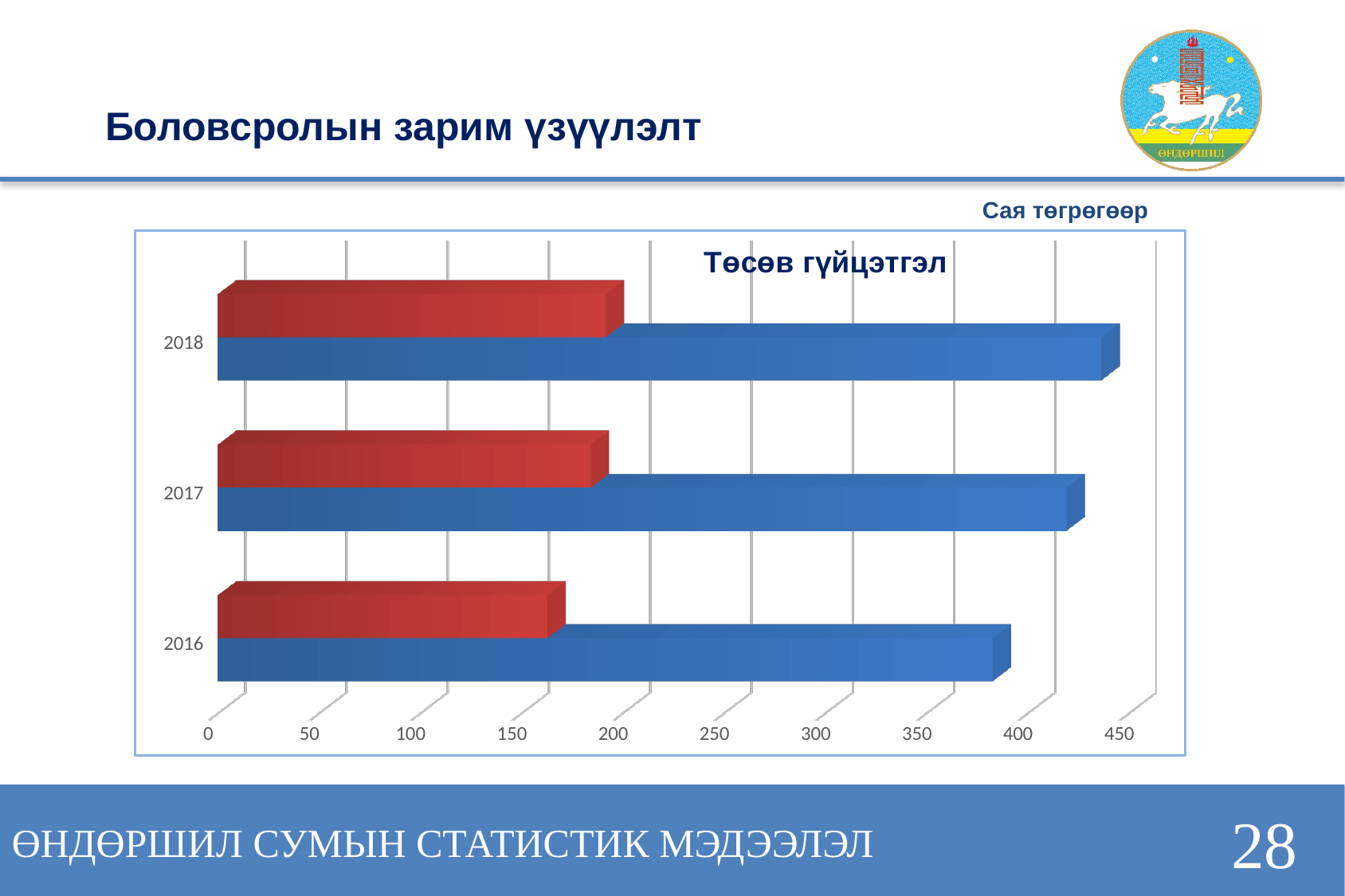
For 2018, which bar is larger, the blue one or the red one? blue In which year is the blue bar the longest? 2018 Is the value of the red bar for 2016 greater or less than 200? less What kind of chart is shown on the slide? bar chart What is the title of the chart? Төсөв гүйцэтгэл Is the value of the blue bar for 2016 greater or less than 400? less How many years (categories) are shown on the chart? 3 In which year is the red bar the shortest? 2016 Do the blue bars rise or fall from 2016 to 2018? rise Is the value of the blue bar for 2018 greater or less than 400? greater How many bars are plotted for each year on the chart? 2